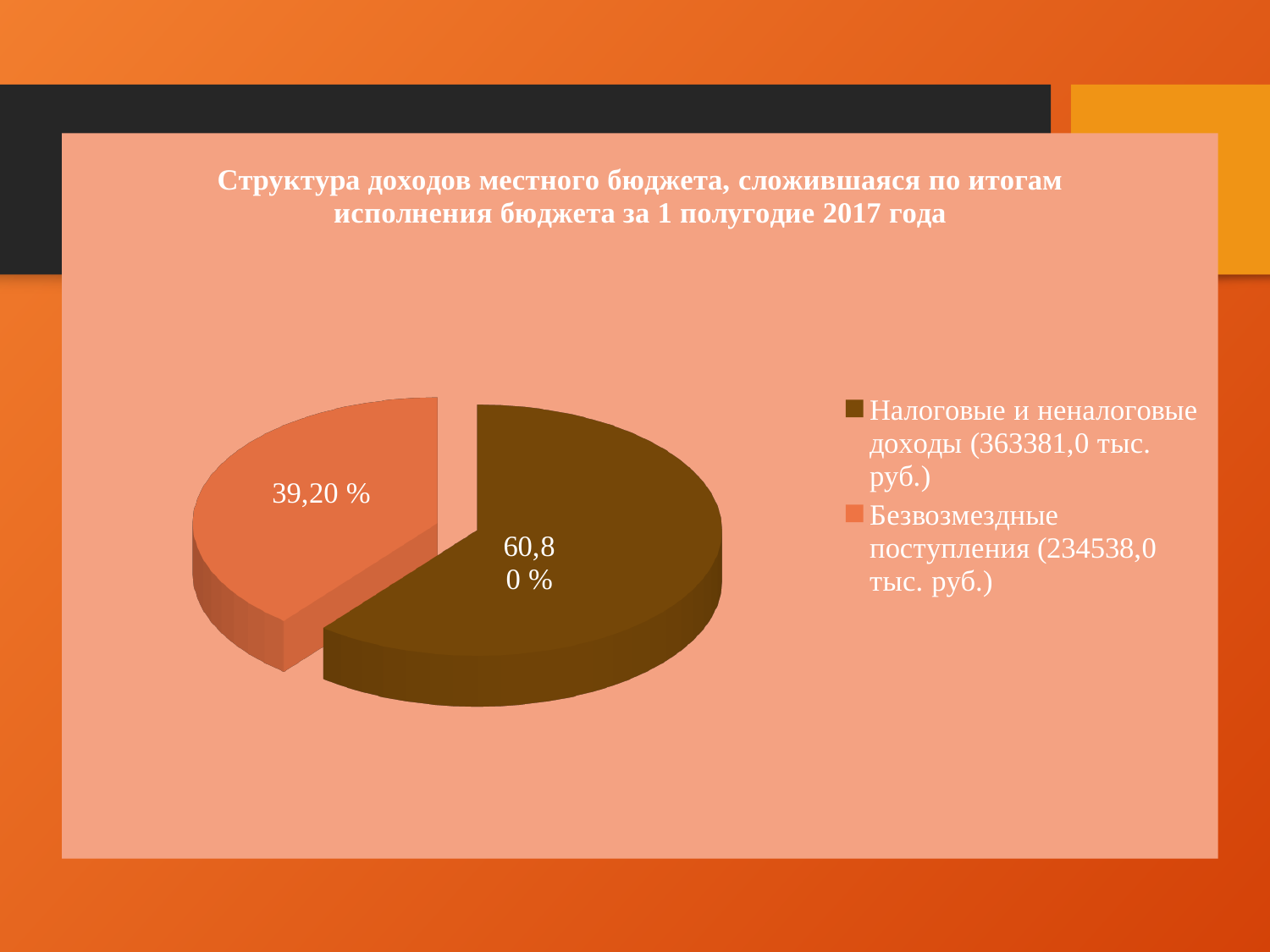
What kind of chart is shown on the slide? pie chart Which is larger: the share for Налоговые и неналоговые доходы or the share for Безвозмездные поступления? Налоговые и неналоговые доходы Which slice of the pie chart is the largest? Налоговые и неналоговые доходы Which slice of the pie chart is the smallest? Безвозмездные поступления What amount in тыс. руб. does the legend give for Безвозмездные поступления? 234538,0 тыс. руб. What is the difference in percentage points between the share for Налоговые и неналоговые доходы and the share for Безвозмездные поступления? 21,60 % How many entries does the legend of the pie chart list? 2 How many slices does the pie chart have? 2 What share of the pie is labelled for Налоговые и неналоговые доходы? 60,80 % What share of the pie is labelled for Безвозмездные поступления? 39,20 % What colour is the slice for Безвозмездные поступления in the pie chart? orange What amount in тыс. руб. does the legend give for Налоговые и неналоговые доходы? 363381,0 тыс. руб.